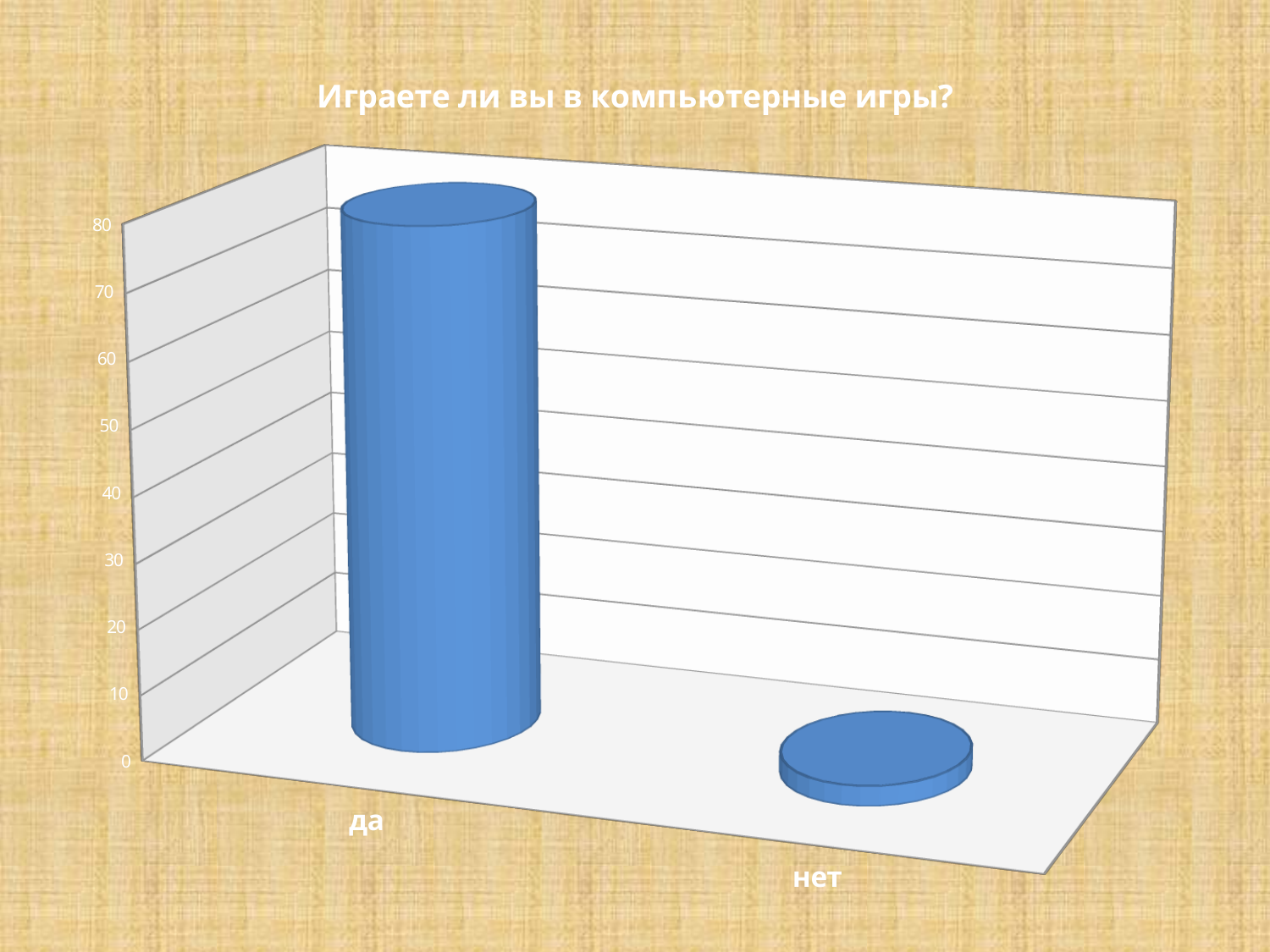
What is the title of the chart? Играете ли вы в компьютерные игры? Is the value for да greater or less than 50? greater Which category has the lowest value? нет Which is larger, the value for да or the value for нет? да Is the value for нет greater or less than 10? less Which category has the highest value? да What is the highest value shown on the vertical axis? 80 Is the value for да greater or less than 30? greater How many categories are shown on the chart? 2 What kind of chart is shown on the slide? bar chart